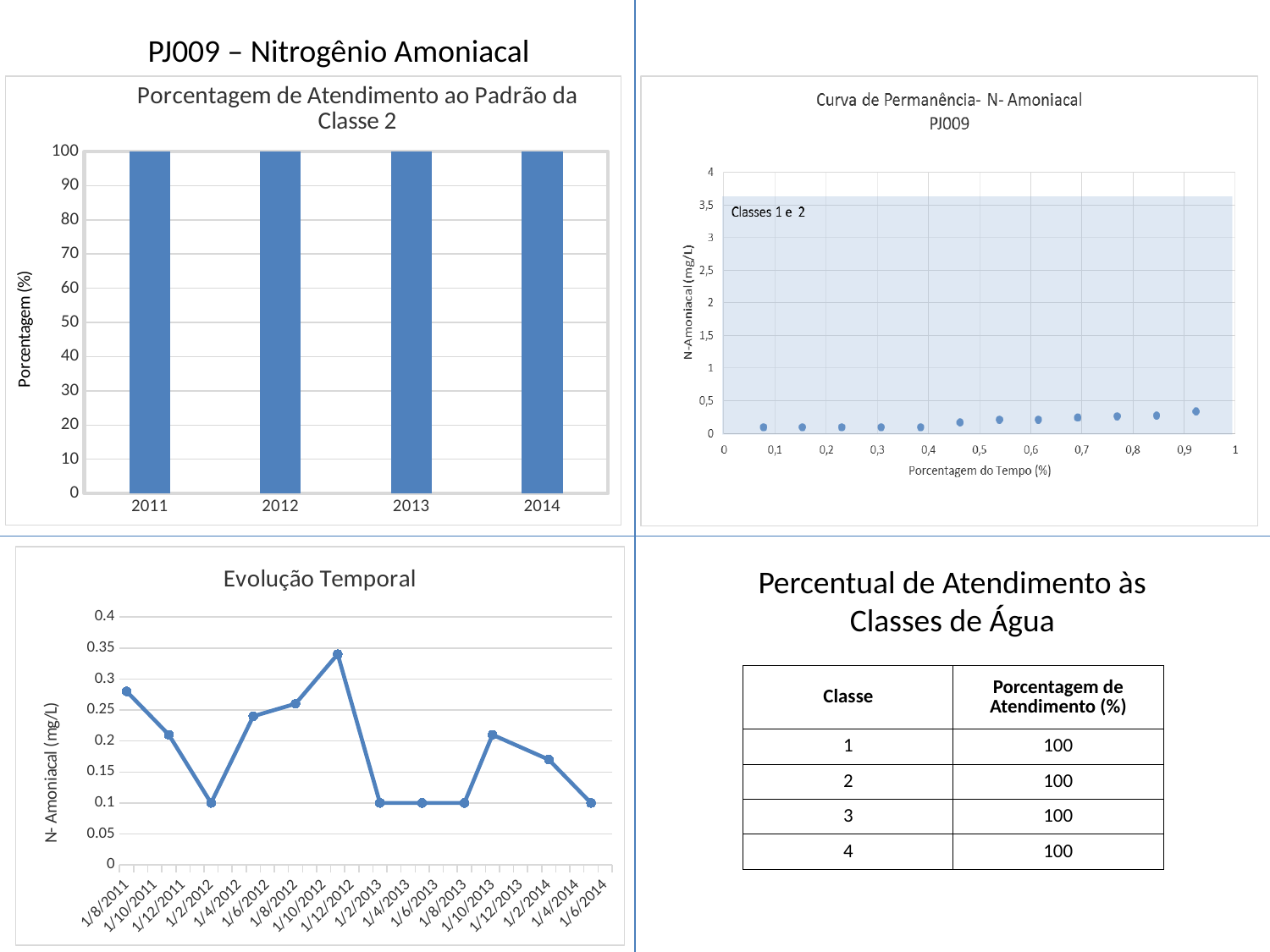
In the chart 'Curva de Permanência - N-Amoniacal PJ009', do the values rise or fall as the percentage of time increases? rise In the chart 'Porcentagem de Atendimento ao Padrão da Classe 2', what is the value for 2011? 100 In the chart 'Evolução Temporal', what is the lowest value plotted? 0.1 What kind of chart is 'Porcentagem de Atendimento ao Padrão da Classe 2'? bar chart How many years are shown in the chart 'Porcentagem de Atendimento ao Padrão da Classe 2'? 4 What is the y-axis label of the chart 'Porcentagem de Atendimento ao Padrão da Classe 2'? Porcentagem (%) In the chart 'Porcentagem de Atendimento ao Padrão da Classe 2', what is the difference between the values for 2012 and 2013? 0 In the chart 'Evolução Temporal', is the highest plotted value greater or less than 0.3? greater In the chart 'Curva de Permanência - N-Amoniacal PJ009', is the highest plotted value greater or less than 0,5? less What kind of chart is 'Evolução Temporal'? line chart What is the x-axis label of the chart 'Curva de Permanência - N-Amoniacal PJ009'? Porcentagem do Tempo (%) In the chart 'Porcentagem de Atendimento ao Padrão da Classe 2', what is the value for 2014? 100